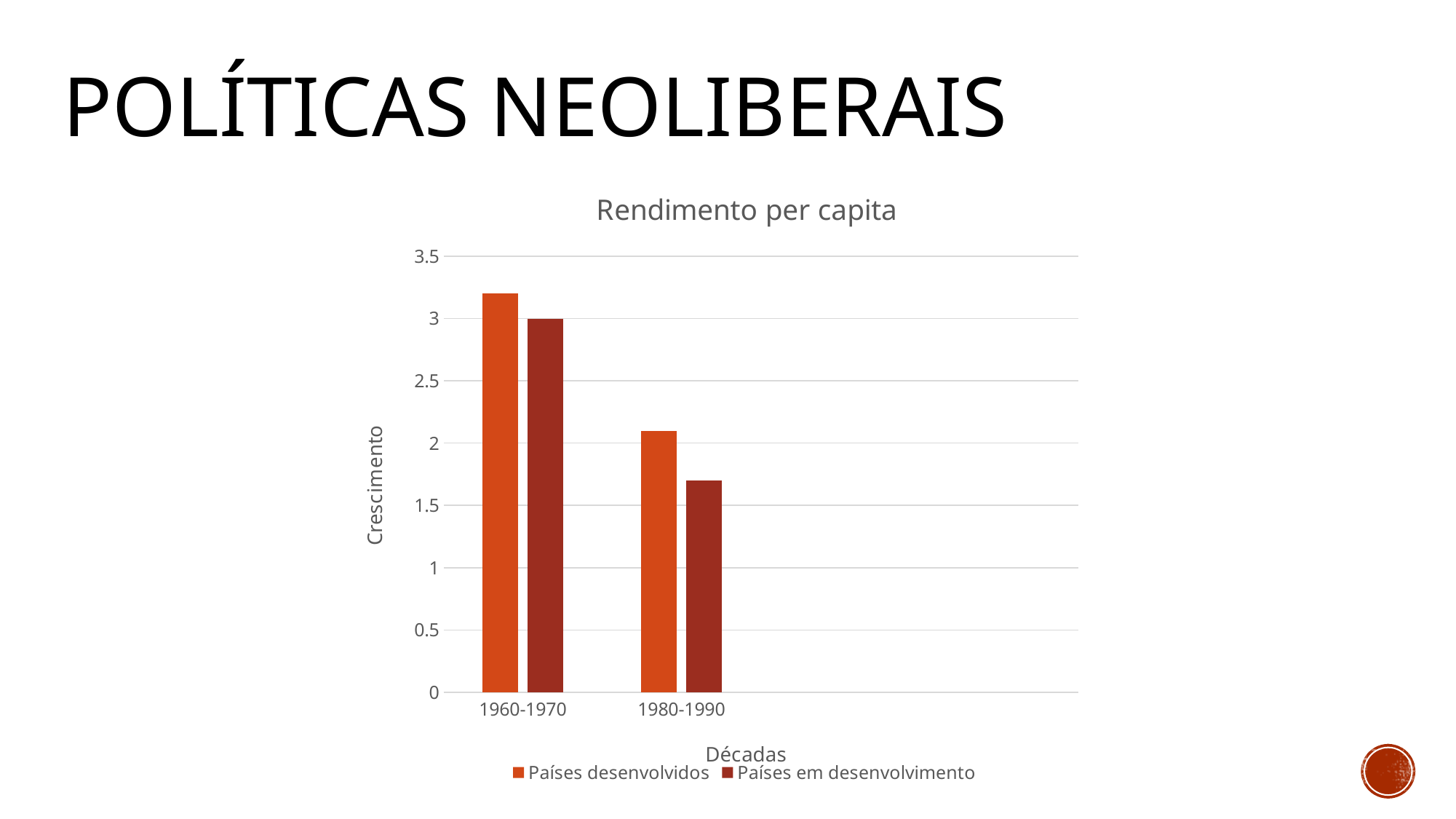
Is the value for Países desenvolvidos in 1980-1990 greater or less than 2? greater In 1980-1990, which series has the larger value, Países desenvolvidos or Países em desenvolvimento? Países desenvolvidos What is the title of the chart? Rendimento per capita Which bar is the highest in the chart? Países desenvolvidos, 1960-1970 What kind of chart is shown on the slide? bar chart What is the label of the vertical axis? Crescimento How many series does the legend list? 2 Which bar is the lowest in the chart? Países em desenvolvimento, 1980-1990 Do the values for Países em desenvolvimento rise or fall from 1960-1970 to 1980-1990? fall How many decade categories are shown on the x axis? 2 Is the value for Países desenvolvidos in 1960-1970 greater or less than 3? greater Is the value for Países em desenvolvimento in 1980-1990 greater or less than 2? less